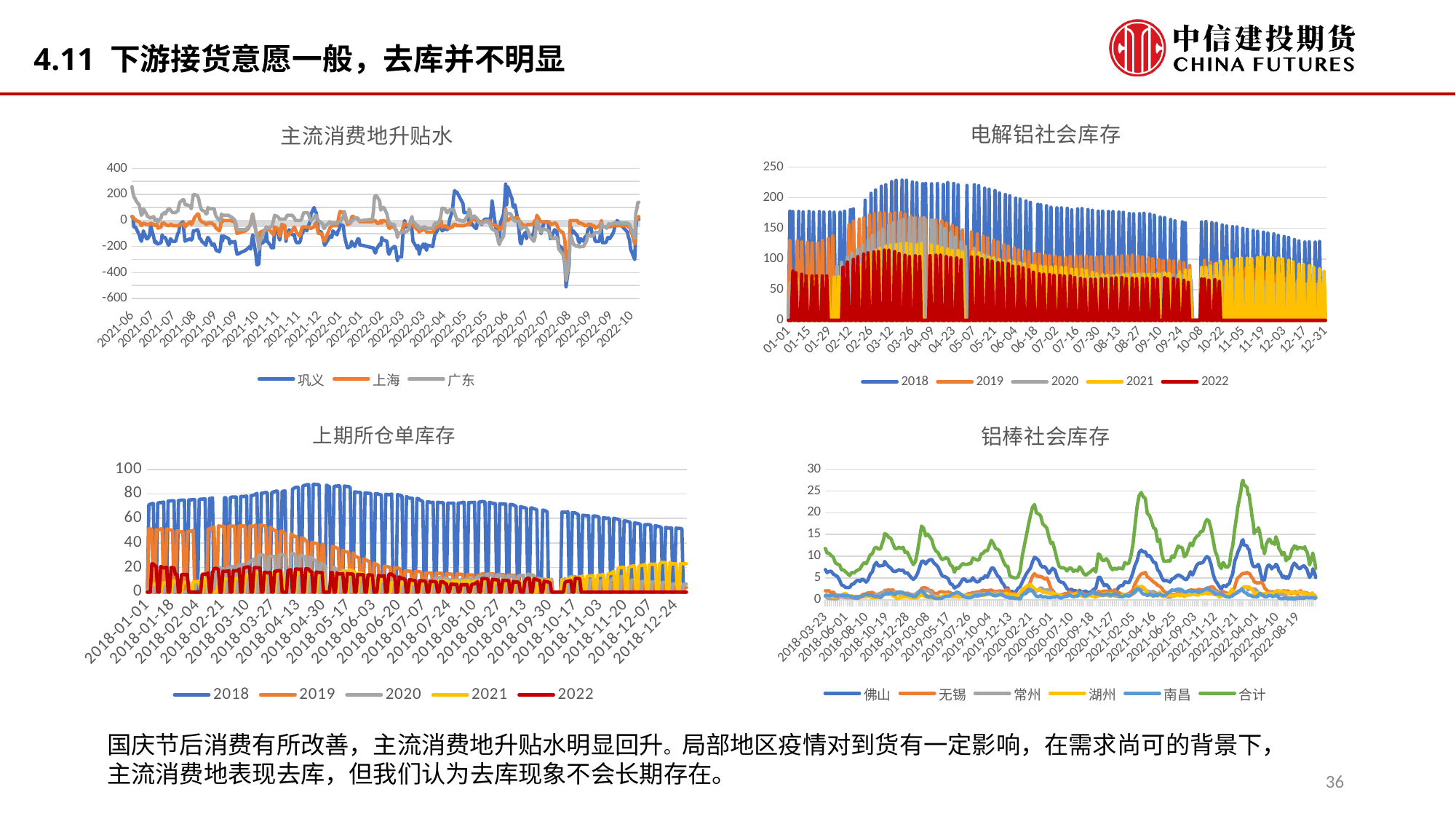
In the '电解铝社会库存' chart, is the peak value of the 2018 series greater or less than 200? greater In the '上期所仓单库存' chart, does the 2018 series rise or fall from 04-30 to 12-24? fall Which series in the '主流消费地升贴水' chart is drawn in orange? 上海 In the '铝棒社会库存' chart, which series has the highest values overall? 合计 In the '主流消费地升贴水' chart, is the lowest value of the 巩义 series greater or less than -400? less How many series does the legend of the '主流消费地升贴水' chart list? 3 How many series does the legend of the '铝棒社会库存' chart list? 6 How many series does the legend of the '上期所仓单库存' chart list? 5 In the '上期所仓单库存' chart, is the peak value of the 2018 series greater or less than 80? greater What type of chart is the '电解铝社会库存' chart? line chart In the '铝棒社会库存' chart, which series is higher around 2022-04-01, 合计 or 佛山? 合计